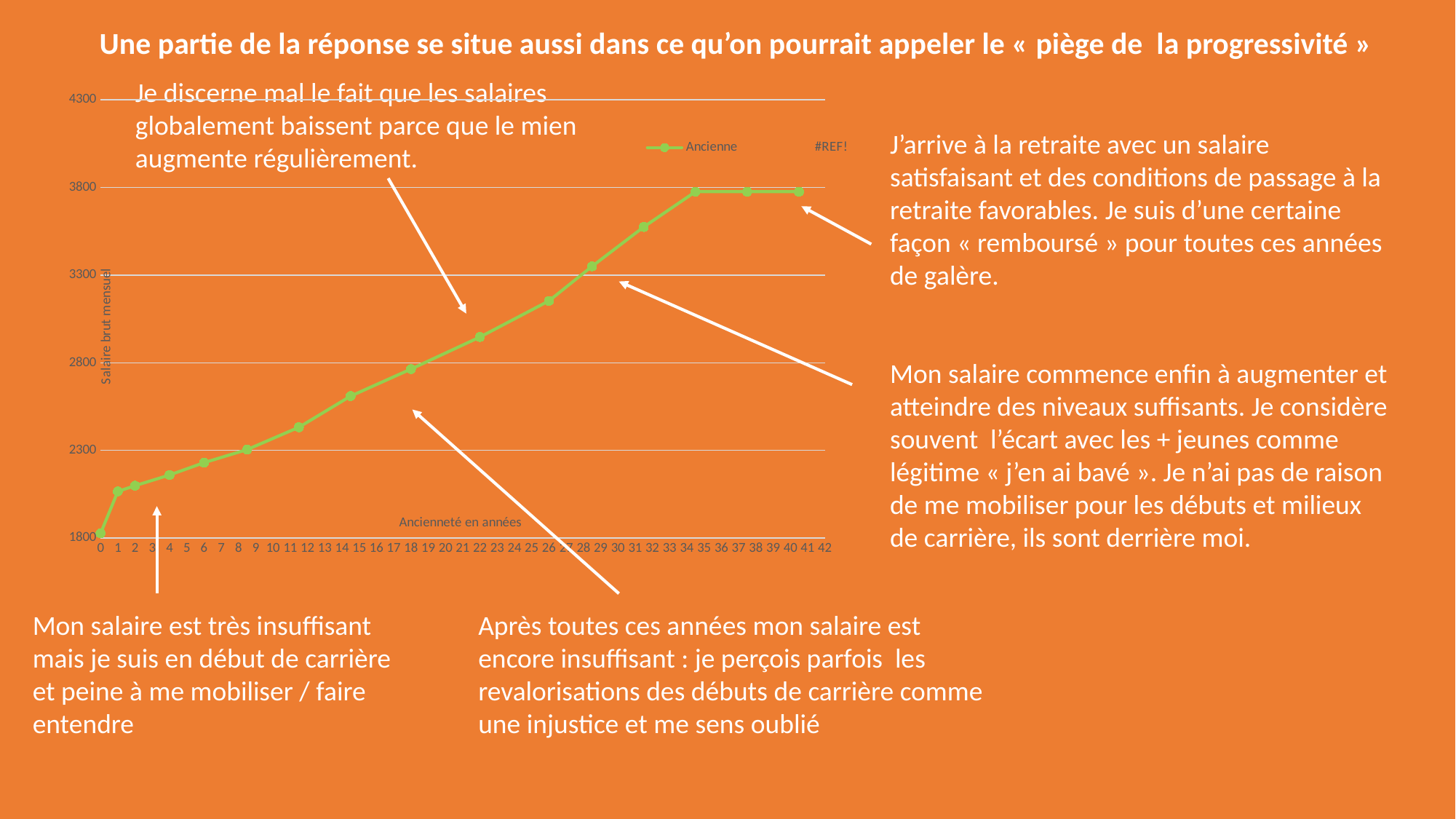
How many entries does the chart legend list? 2 What is the title of the vertical axis? Salaire brut mensuel Do the values rise or fall as seniority (Ancienneté en années) increases? rise What kind of chart is shown on the slide? line chart Is the value at 22 years of seniority greater or less than 2800? greater Is the value at 11 years of seniority greater or less than 2300? greater At which seniority is the salary lowest? 0 Which is larger, the value at 14 years of seniority or the value at 28 years? 28 years Is the value at 31 years of seniority greater or less than 3300? greater What is the name of the plotted series in the legend? Ancienne